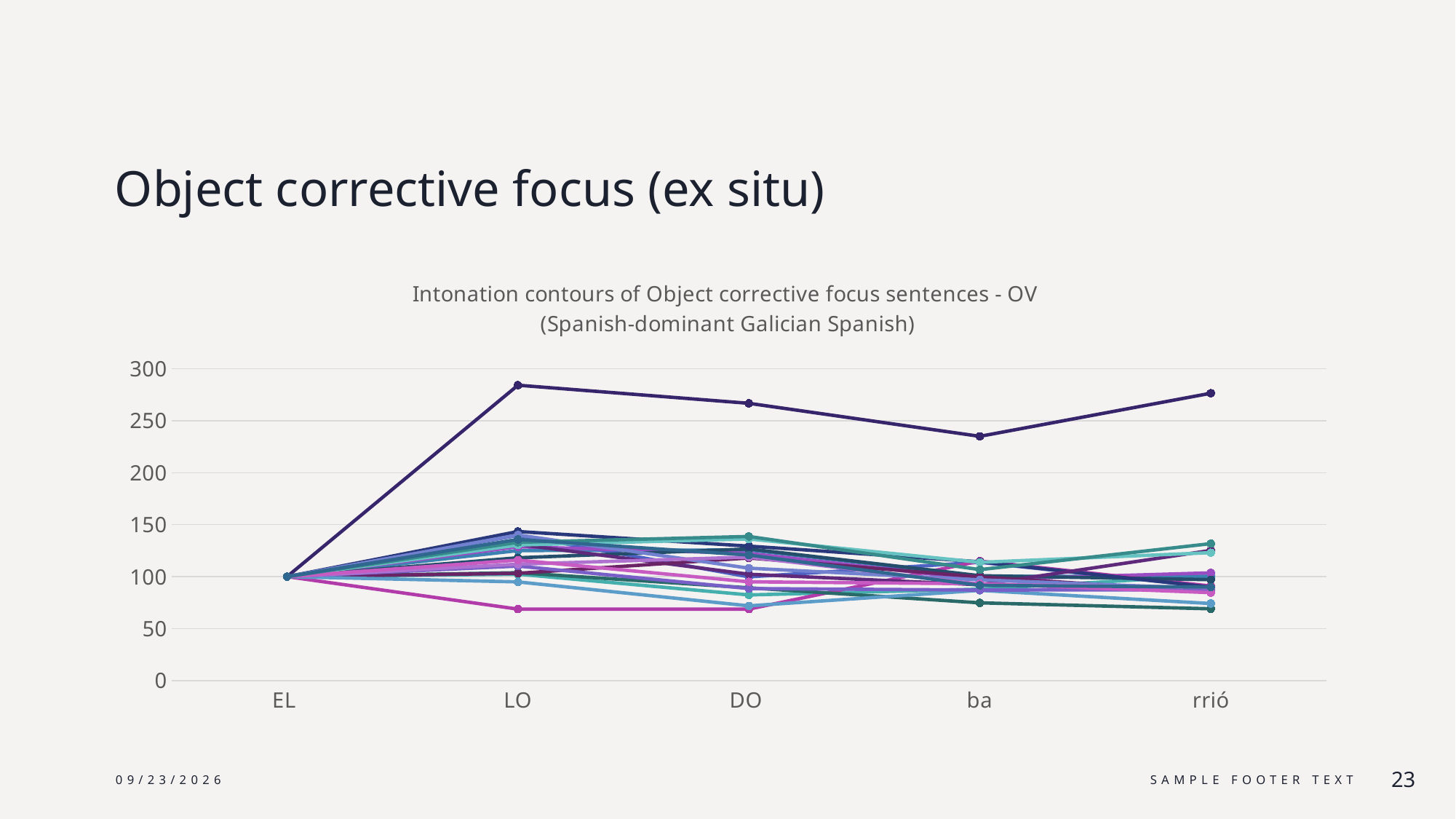
Which is larger for the topmost line: the value at LO or the value at ba? LO Is the lowest value at rrió greater or less than 100? less Is the highest value at rrió greater or less than 250? greater How many categories are shown on the x axis? 5 Is the highest value at ba greater or less than 250? less What kind of chart is shown on the slide? line chart At which category does the chart reach its highest plotted value? LO What is the last category label on the x axis? rrió What value do all the lines share at EL? 100 What is the title of the chart? Intonation contours of Object corrective focus sentences - OV (Spanish-dominant Galician Spanish)